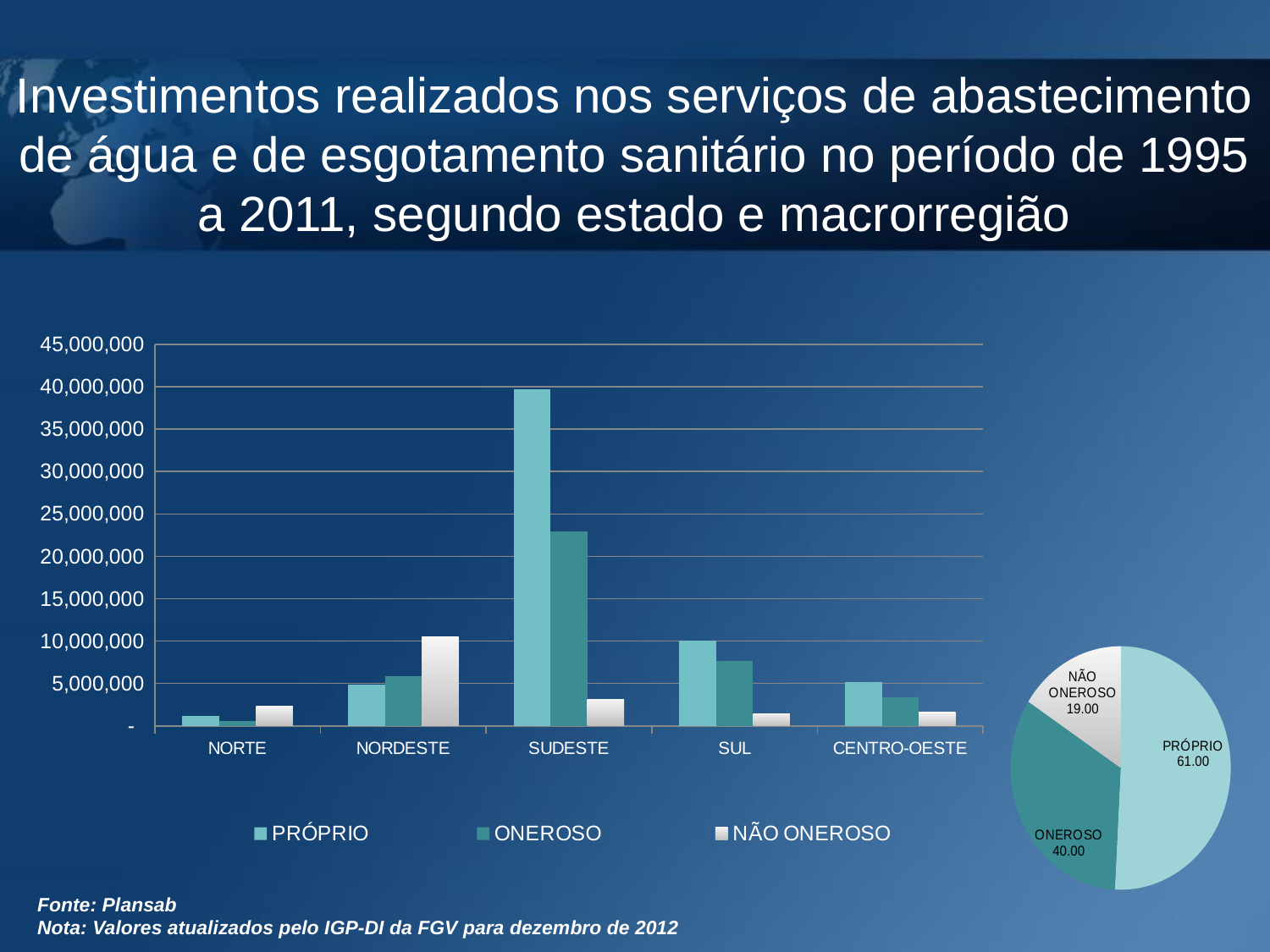
In the bar chart on the left, which region has the highest PRÓPRIO bar? SUDESTE In the pie chart on the right, what is the value shown for NÃO ONEROSO? 19.00 In the bar chart on the left, which region has the lowest PRÓPRIO bar? NORTE In the bar chart on the left, what kind of chart is it? bar chart In the pie chart on the right, what is the value shown for PRÓPRIO? 61.00 In the bar chart on the left, is the PRÓPRIO value for SUDESTE greater or less than 35,000,000? greater In the bar chart on the left, for NORDESTE, which is larger: the ONEROSO bar or the NÃO ONEROSO bar? NÃO ONEROSO In the bar chart on the left, how many regions are shown on the x axis? 5 In the bar chart on the left, is the ONEROSO value for SUDESTE greater or less than 20,000,000? greater In the bar chart on the left, is the PRÓPRIO value for NORTE greater or less than 5,000,000? less In the pie chart on the right, what is the difference between the PRÓPRIO and ONEROSO values? 21.00 In the bar chart on the left, how many series does the legend list? 3